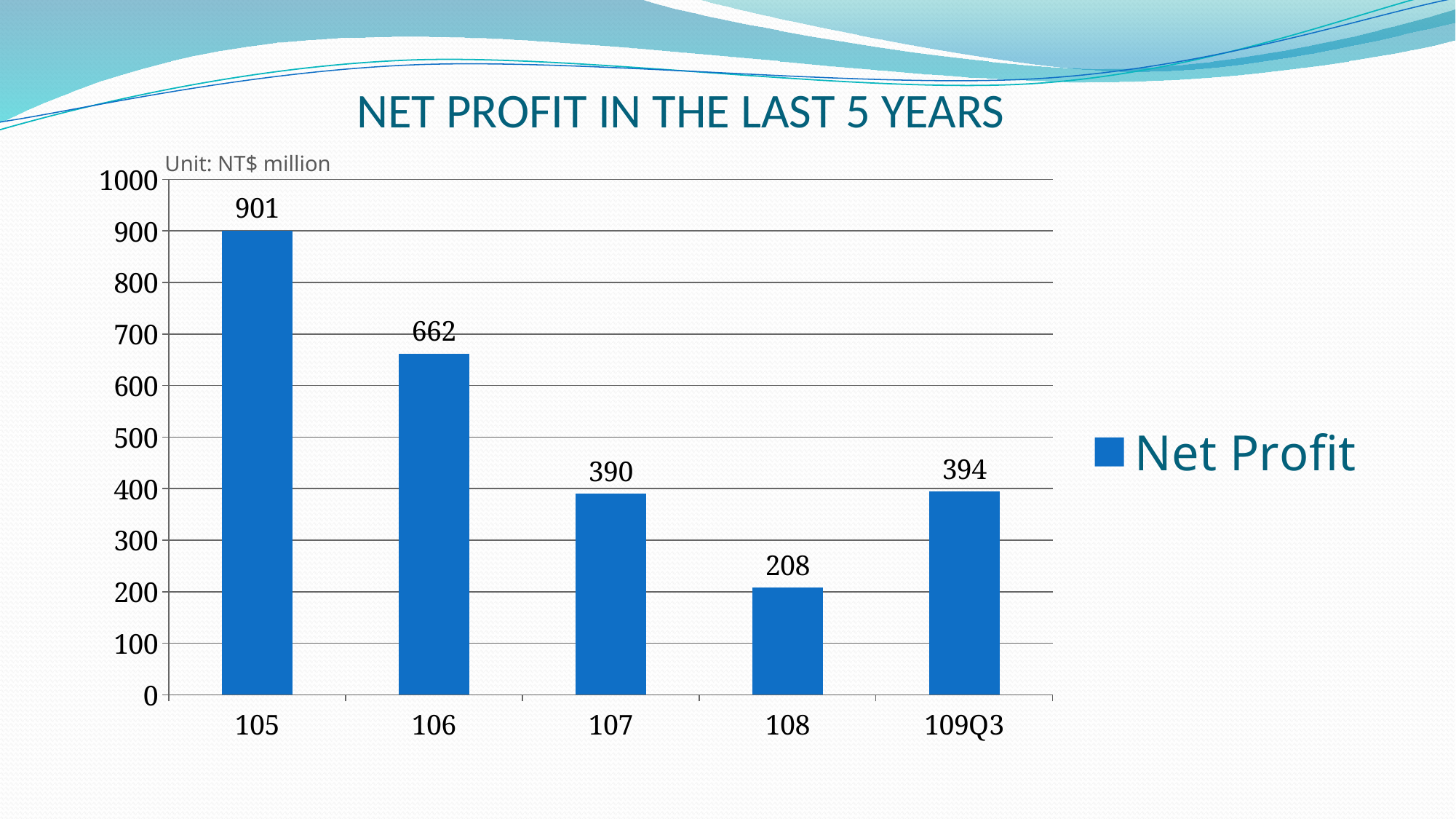
What is the net profit for 109Q3? 394 How many categories are shown on the x axis? 5 Is the net profit for 106 greater or less than 600? greater Which is larger, the net profit for 107 or 109Q3? 109Q3 What kind of chart is shown on the slide? bar chart Which year has the highest net profit? 105 What is the net profit for 108? 208 Which year has the lowest net profit? 108 What unit is stated for the values in the chart? NT$ million What is the difference between the net profit for 105 and 106? 239 What is the net profit for 105? 901 How many series does the legend list? 1